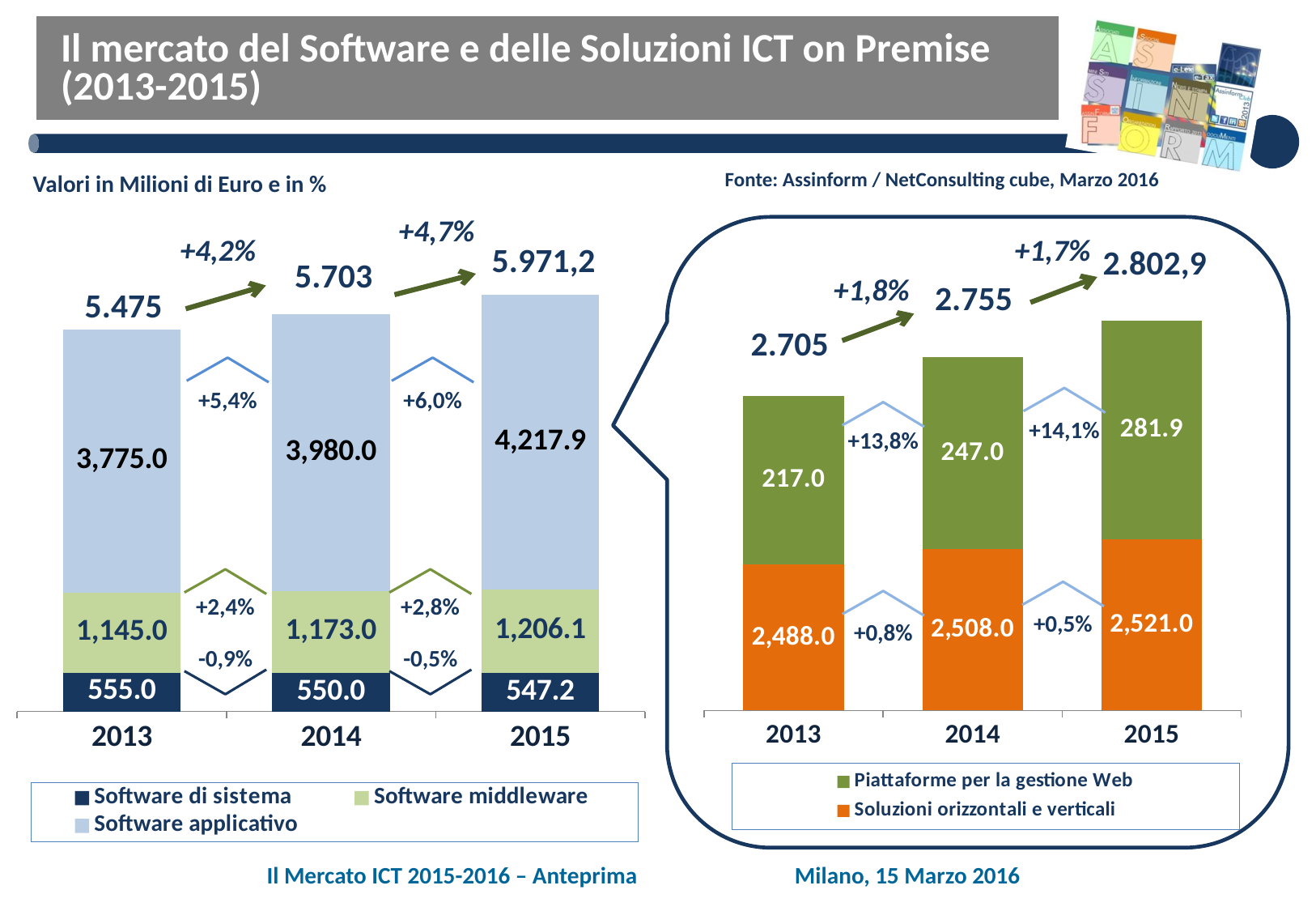
In the left chart, what is the value for Software di sistema in 2015? 547.2 In the left chart, does the Software applicativo value rise or fall from 2013 to 2015? rise In the right chart, what is the value for Soluzioni orizzontali e verticali in 2013? 2,488.0 In the left chart, which year has the lowest value for Software di sistema? 2015 In the left chart, how many series does the legend list? 3 In the left chart, what is the total shown above the 2013 stacked bar? 5.475 What kind of chart is the right chart? stacked bar chart In the left chart, what is the difference between the Software middleware values for 2015 and 2013? 61.1 In the right chart, which is larger in 2014: Soluzioni orizzontali e verticali or Piattaforme per la gestione Web? Soluzioni orizzontali e verticali In the right chart, what is the total shown above the 2014 stacked bar? 2.755 In the right chart, what is the value for Piattaforme per la gestione Web in 2015? 281.9 In the left chart, what is the value for Software applicativo in 2014? 3,980.0